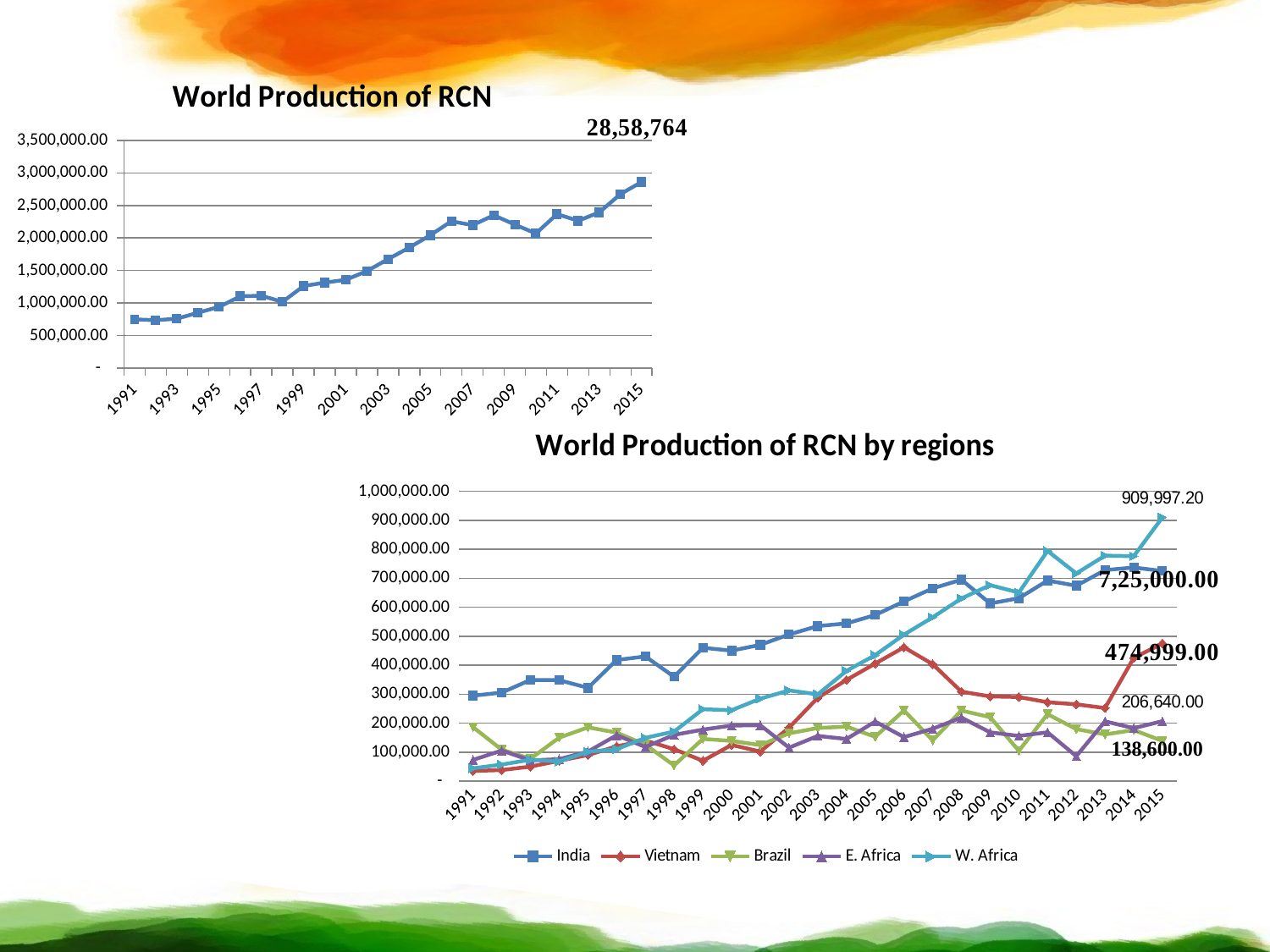
In the 'World Production of RCN by regions' chart, which is larger in 2015: India or Vietnam? India In the 'World Production of RCN' chart, what is the value labelled for 2015? 28,58,764 In the 'World Production of RCN by regions' chart, what is the labelled value for W. Africa in 2015? 909,997.20 In the 'World Production of RCN' chart, do values generally rise or fall from 1991 to 2015? rise What kind of chart is the 'World Production of RCN' chart? line chart In the 'World Production of RCN by regions' chart, what is the labelled value for Vietnam in 2015? 474,999.00 In the 'World Production of RCN by regions' chart, what is the labelled value for India in 2015? 7,25,000.00 In the 'World Production of RCN by regions' chart, what is the labelled value for Brazil in 2015? 138,600.00 In the 'World Production of RCN by regions' chart, which region has the lowest value in 2015? Brazil In the 'World Production of RCN' chart, is the value for 1991 greater or less than 1,000,000.00? less In the 'World Production of RCN by regions' chart, which region has the highest value in 2015? W. Africa How many series does the legend of the 'World Production of RCN by regions' chart list? 5